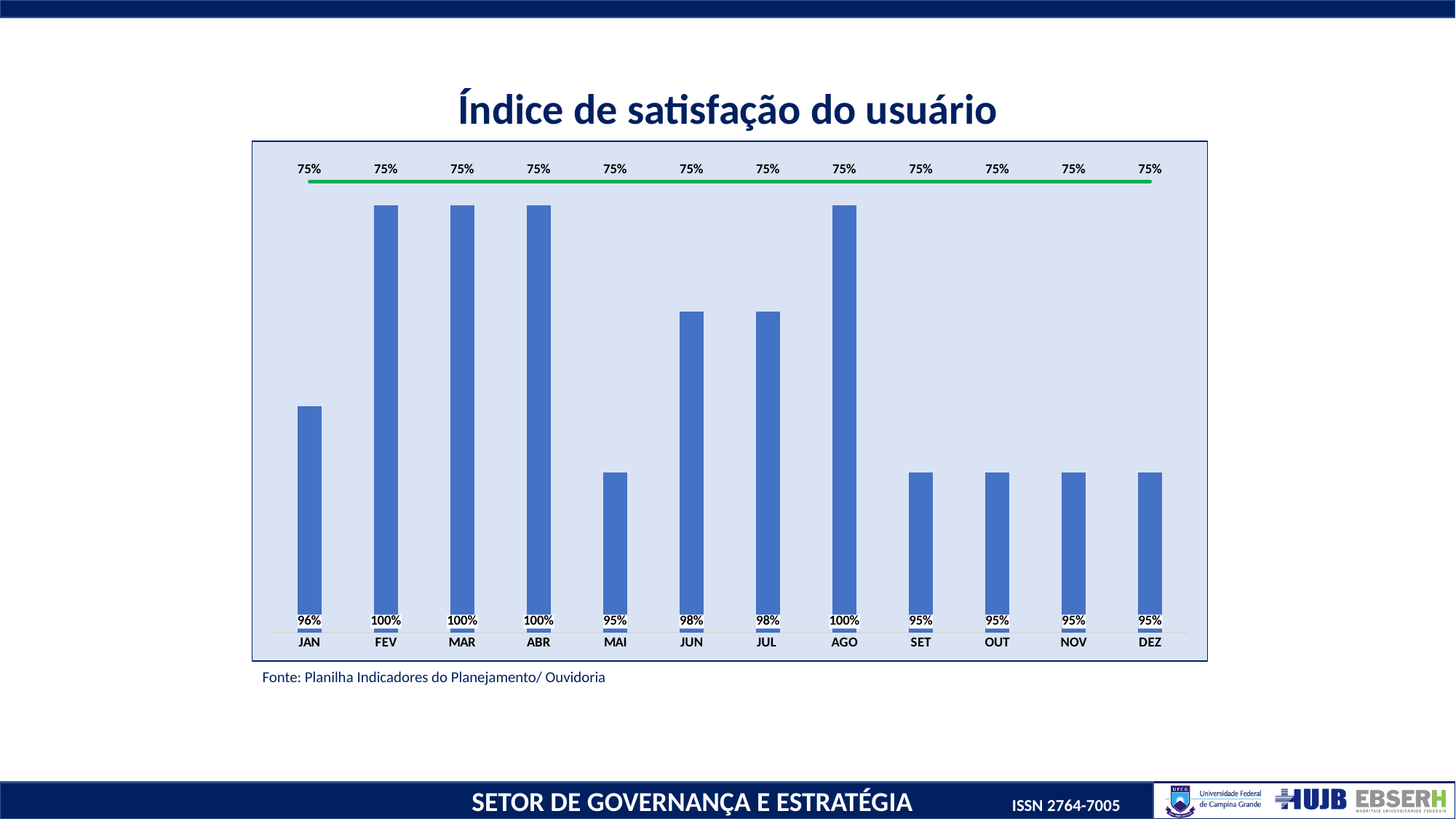
How many months are shown on the x axis of the chart? 12 What is the satisfaction index value for JAN? 96% What kind of chart is used to show the satisfaction index? Bar chart What is the satisfaction index value for JUN? 98% What is the highest satisfaction index value shown on the chart? 100% What is the satisfaction index value for DEZ? 95% Which month has a higher satisfaction index, JAN or JUL? JUL What is the difference between the satisfaction index for FEV and for MAI? 5% What is the lowest satisfaction index value shown on the chart? 95% What is the value of the green target line shown for each month? 75% Do the satisfaction index values rise or fall from AGO to SET? Fall What is the title of the chart? Índice de satisfação do usuário